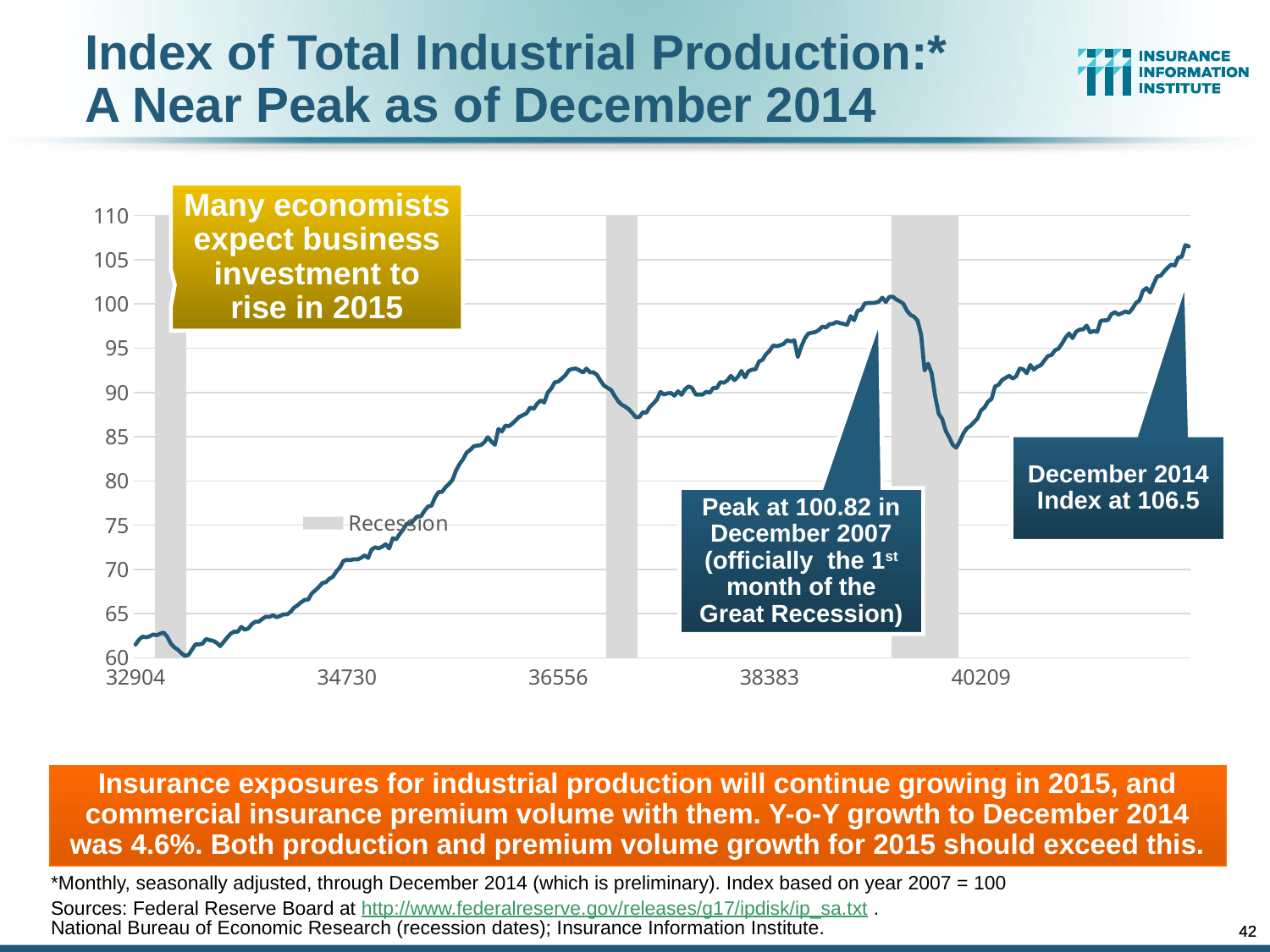
Overall, does the index rise or fall from the left of the chart to the right? rise Is the December 2014 index value greater or less than 105? greater What was the Index of Total Industrial Production in December 2014? 106.5 Which is higher, the December 2007 peak or the December 2014 index value? December 2014 Is the index value at the start of the series (left edge of the chart) greater or less than 65? less What kind of chart is shown on the slide? line chart How many shaded recession periods are marked on the chart? 3 By how much does the December 2014 index value exceed the December 2007 peak? 5.68 What is the range of the vertical axis on the chart? 60 to 110 What do the grey shaded bands on the chart represent, according to the legend? Recession Is the lowest index value reached after the Great Recession greater or less than 90? less What value did the index peak at in December 2007? 100.82